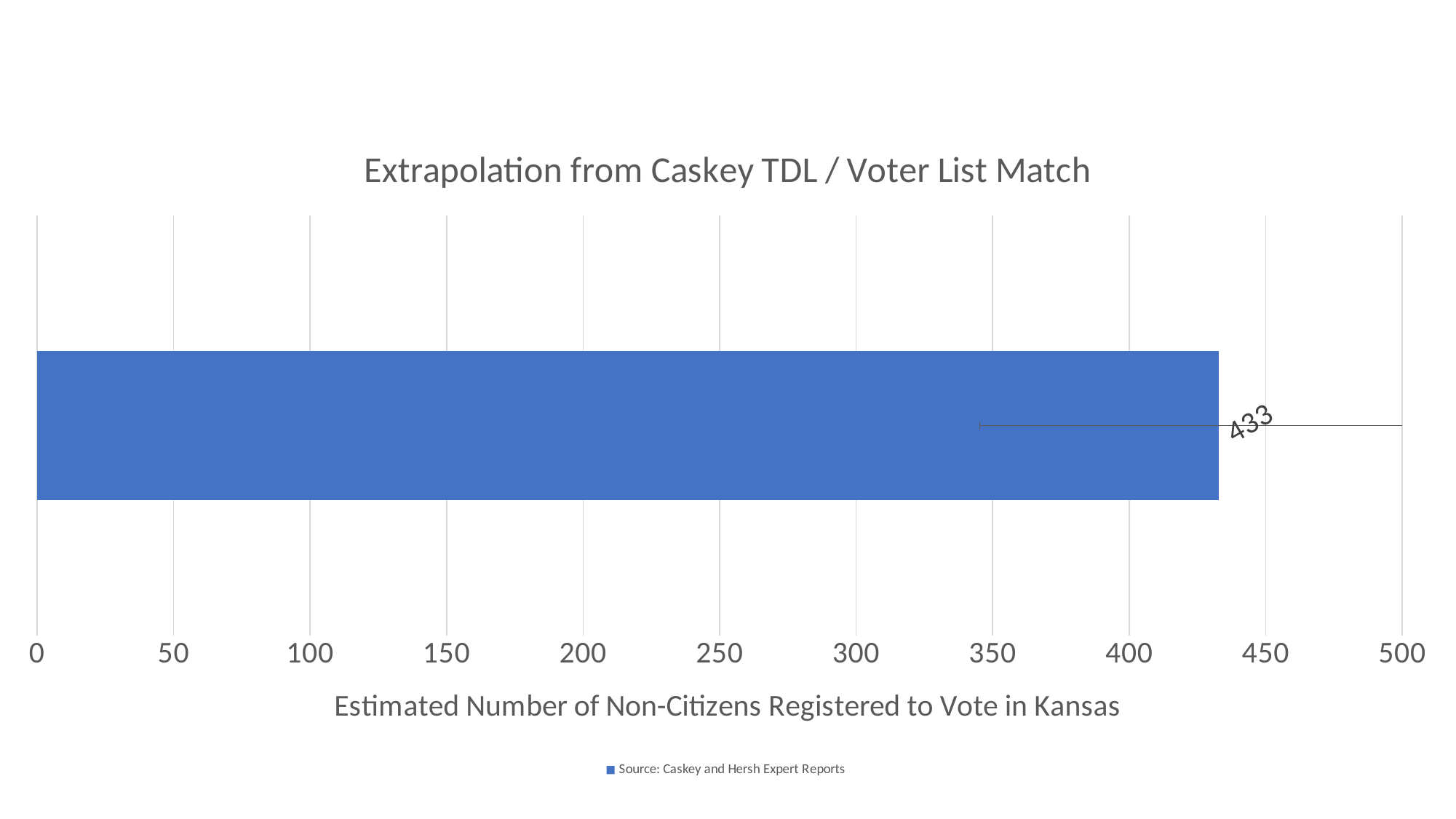
Is the value of the bar greater or less than 450? less What is the title of the chart? Extrapolation from Caskey TDL / Voter List Match How many bars are plotted in the chart? 1 Is the value of the bar greater or less than 400? greater What is the maximum value shown on the horizontal axis? 500 What kind of chart is shown on the slide? bar chart How many series does the legend list? 1 What is the value shown by the bar in the chart? 433 What is the label of the horizontal axis? Estimated Number of Non-Citizens Registered to Vote in Kansas